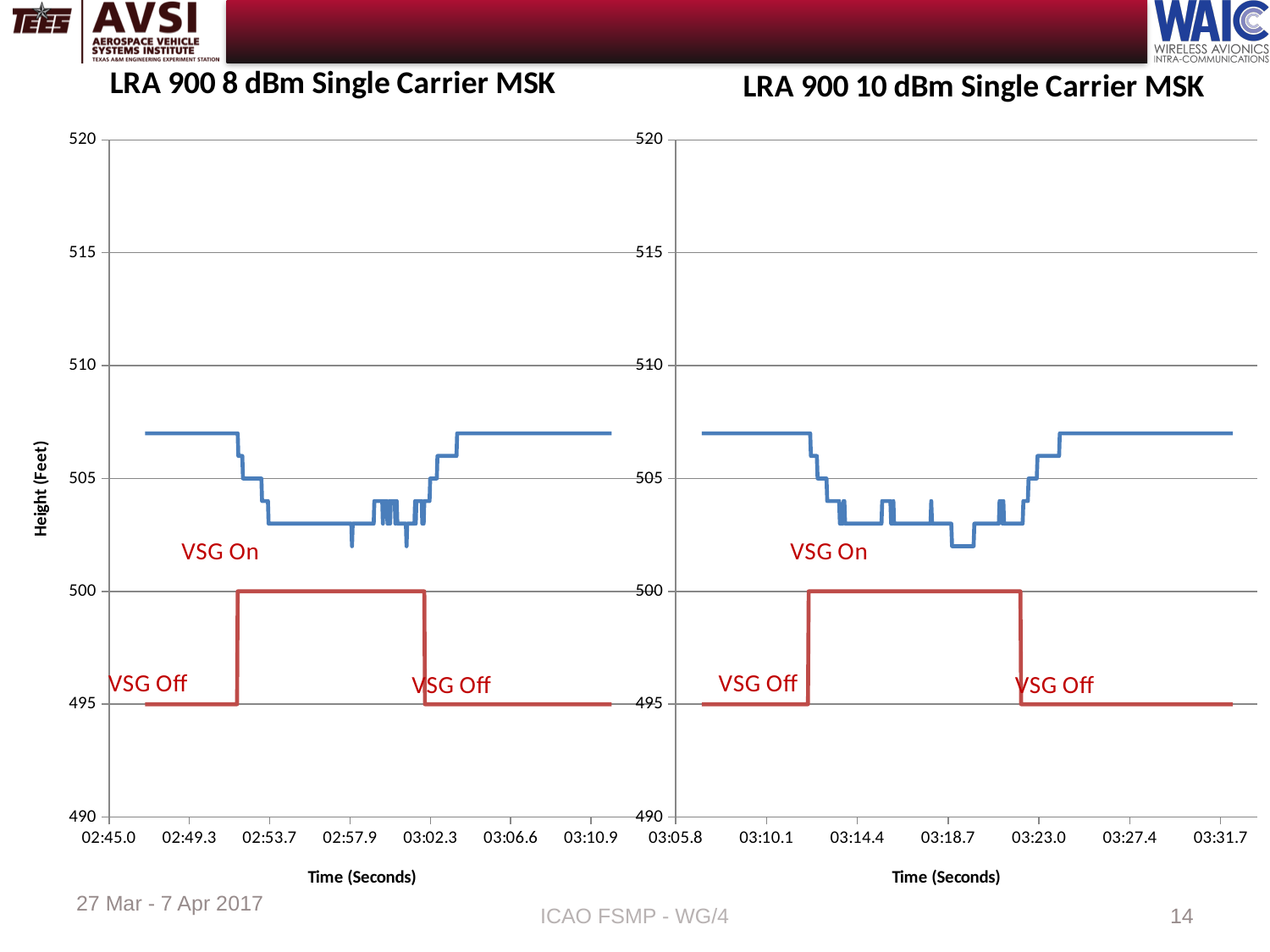
In the right chart, is the lowest point of the blue height line greater or less than 505? less In the left chart, is the blue height line at the start of the time range greater or less than 505? greater In the right chart, does the blue height line rise or fall when the red line switches to VSG On? fall In the left chart, is the red line higher during VSG On or during VSG Off? VSG On How many time tick labels are shown on the x-axis of the right chart? 7 In the right chart, what height value does the red line sit at while VSG is On? 500 In the left chart, what height value does the red line sit at while VSG is Off? 495 In the left chart, is the lowest point of the blue height line greater or less than 500? greater In the left chart, what is the y-axis label? Height (Feet) In the right chart, what is the difference between the red line's VSG On level and its VSG Off level? 5 What is the title of the right chart? LRA 900 10 dBm Single Carrier MSK What kind of chart is the left chart titled 'LRA 900 8 dBm Single Carrier MSK'? line chart